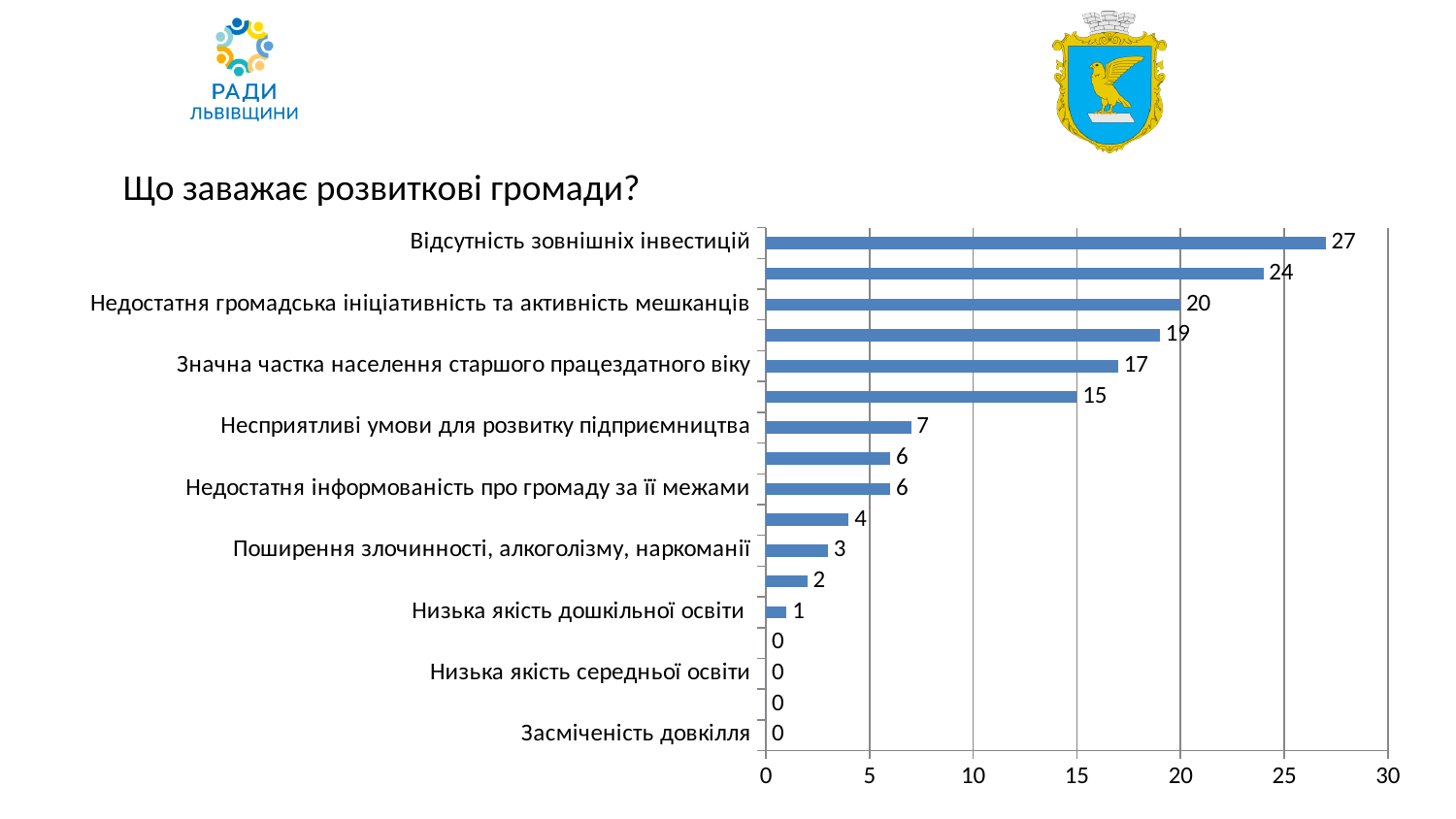
What is the value for "Відсутність зовнішніх інвестицій"? 27 Which is larger: the value for "Значна частка населення старшого працездатного віку" or for "Несприятливі умови для розвитку підприємництва"? Значна частка населення старшого працездатного віку What is the value for "Несприятливі умови для розвитку підприємництва"? 7 What is the difference between the values for "Відсутність зовнішніх інвестицій" and "Недостатня громадська ініціативність та активність мешканців"? 7 What is the value for "Значна частка населення старшого працездатного віку"? 17 Is the value for "Недостатня інформованість про громаду за її межами" greater or less than 10? less Which category has the highest value? Відсутність зовнішніх інвестицій What kind of chart is shown on the slide? Bar chart What is the value for "Низька якість дошкільної освіти"? 1 What is the value for "Поширення злочинності, алкоголізму, наркоманії"? 3 What is the value for "Недостатня громадська ініціативність та активність мешканців"? 20 What is the title of the chart? Що заважає розвиткові громади?